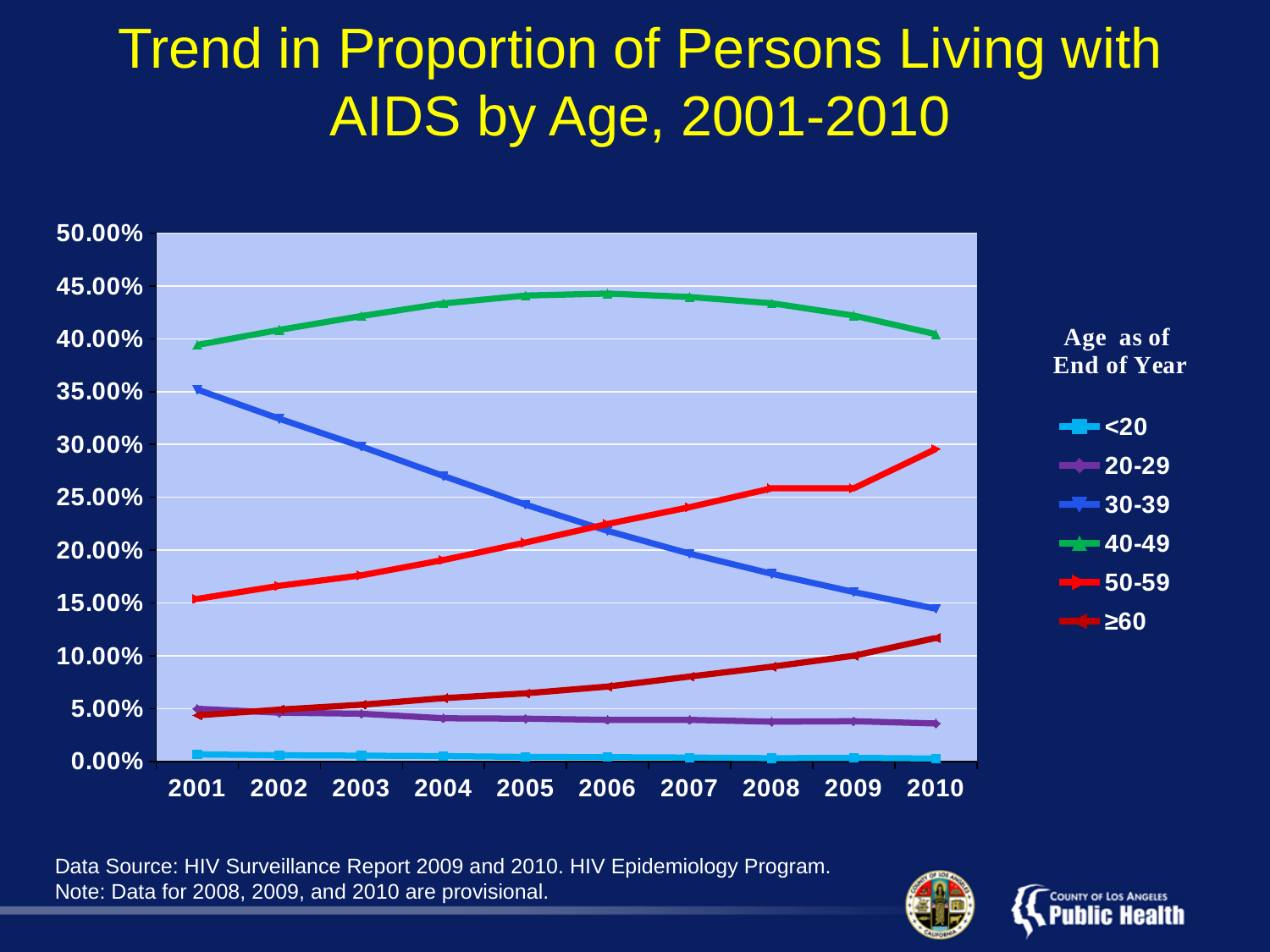
Which age group has the highest proportion in 2010? 40-49 In 2010, which is larger: the proportion for 50-59 or for 30-39? 50-59 What is the title of the legend on the chart? Age as of End of Year In 2001, which is larger: the proportion for 30-39 or for 50-59? 30-39 Does the proportion for the 50-59 age group rise or fall from 2001 to 2010? rise Which age group has the lowest proportion in 2010? <20 Is the value for the 30-39 age group in 2010 greater or less than 20.00%? less How many age groups does the legend list? 6 How many years are shown along the x axis? 10 Is the value for the 40-49 age group in 2006 greater or less than 40.00%? greater What kind of chart is shown on the slide? line chart Does the proportion for the 30-39 age group rise or fall from 2001 to 2010? fall